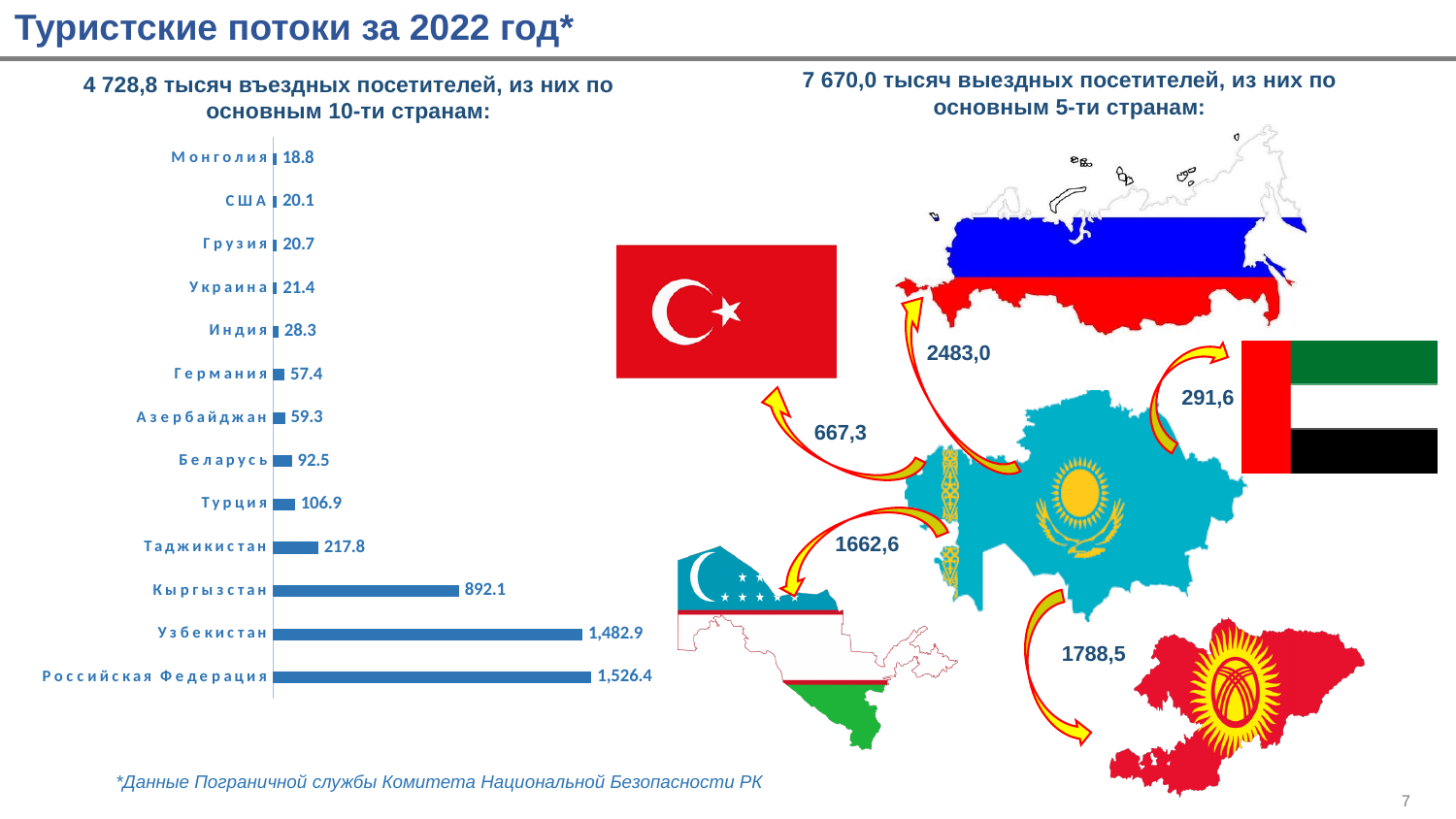
In the bar chart on the left, what is the value for Турция? 106.9 In the bar chart on the left, which country has the lowest value? Монголия In the bar chart on the left, which country has the highest value? Российская Федерация In the bar chart on the left, which is larger: the value for Индия or the value for Украина? Индия In the bar chart on the left, what is the value for Грузия? 20.7 In the bar chart on the left, what is the difference between the values for Российская Федерация and Узбекистан? 43.5 In the bar chart on the left, what is the value for Беларусь? 92.5 In the bar chart on the left, which is larger: the value for Германия or the value for Азербайджан? Азербайджан In the bar chart on the left, what is the value for Узбекистан? 1,482.9 How many countries are shown in the bar chart on the left? 13 What type of chart is shown on the left of the slide? Bar chart In the bar chart on the left, what is the difference between the values for Кыргызстан and Таджикистан? 674.3